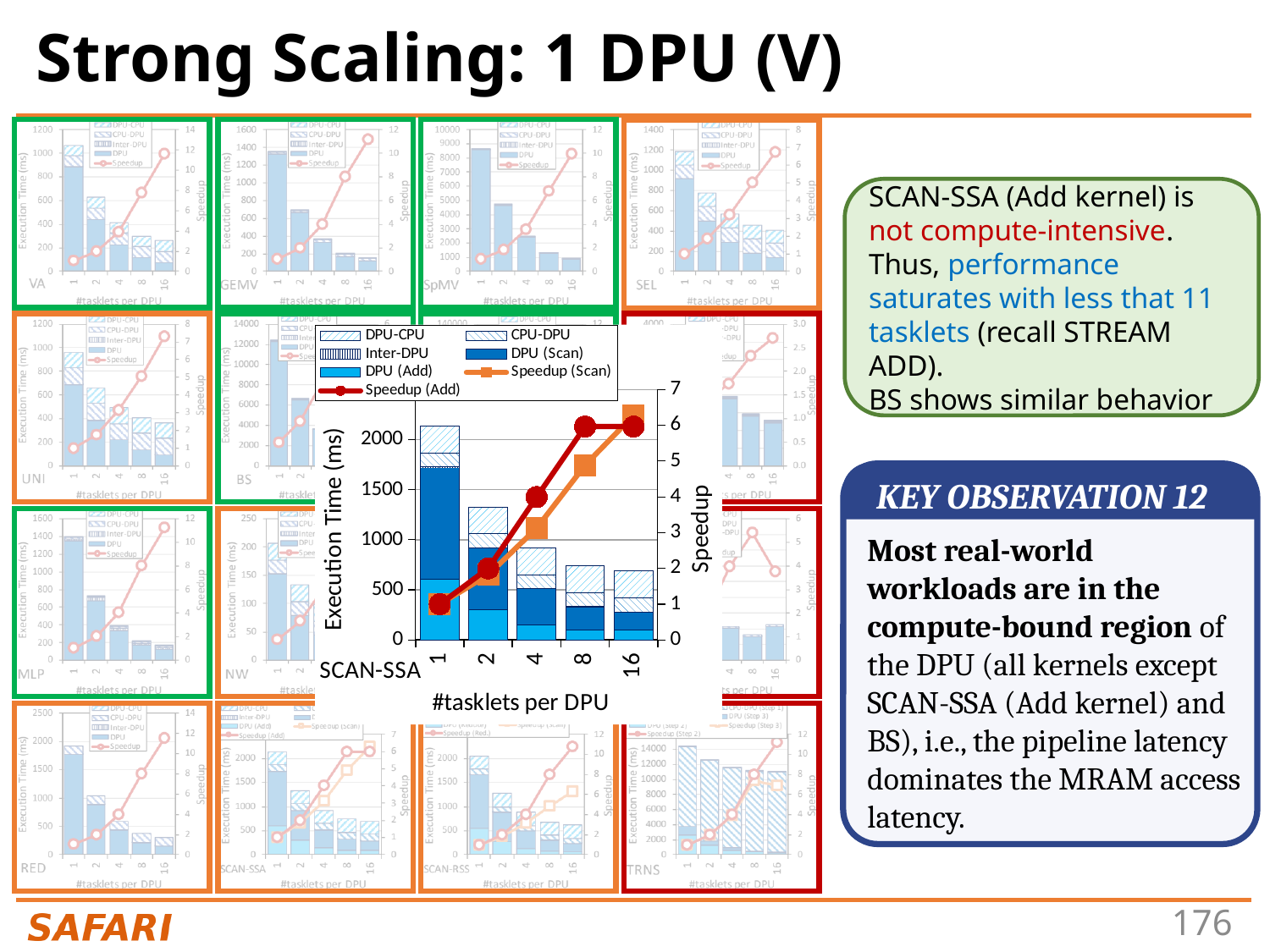
In the enlarged SCAN-SSA chart, how many series does the legend list? 7 In the enlarged SCAN-SSA chart, how many tasklet counts are shown on the x axis? 5 In the enlarged SCAN-SSA chart, is the total execution time at 16 tasklets per DPU greater or less than 1000 ms? less In the enlarged SCAN-SSA chart, how does Speedup (Add) change as the number of tasklets per DPU increases from 1 to 8? It rises In the enlarged SCAN-SSA chart, what is the label of the right-hand y axis? Speedup In the enlarged SCAN-SSA chart, which tasklet count has the highest Speedup (Scan)? 16 In the enlarged SCAN-SSA chart, what kind of chart is used for the execution time data? bar chart (stacked), with speedup lines overlaid In the enlarged SCAN-SSA chart, what is the label of the x axis? #tasklets per DPU In the enlarged SCAN-SSA chart, which tasklet count has the highest total execution time? 1 In the enlarged SCAN-SSA chart, is Speedup (Add) at 8 tasklets per DPU larger or smaller than Speedup (Scan) at 8 tasklets per DPU? larger In the enlarged SCAN-SSA chart, is the total execution time at 1 tasklet per DPU greater or less than 2000 ms? greater In the enlarged SCAN-SSA chart, how does execution time change as the number of tasklets per DPU increases from 1 to 16? It falls